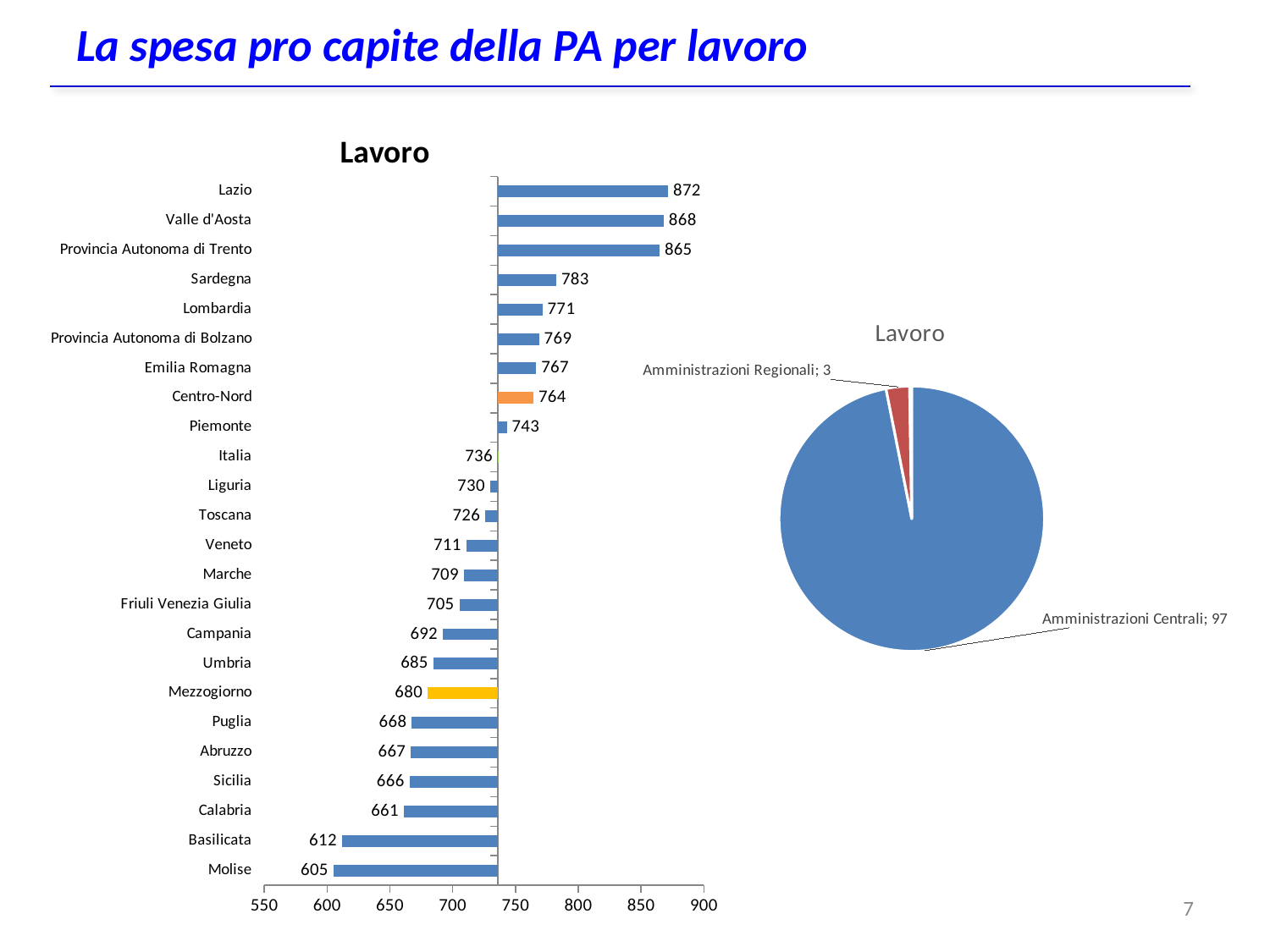
In the bar chart on the left, which category has the lowest value? Molise In the bar chart on the left, what is the difference between the values for Centro-Nord and Mezzogiorno? 84 How many categories are shown in the bar chart on the left? 24 In the bar chart on the left, what is the value for Lazio? 872 What kind of chart is the chart on the left of the slide? Bar chart In the pie chart on the right, what is the value for Amministrazioni Centrali? 97 In the bar chart on the left, which category has the highest value? Lazio In the pie chart on the right, what is the value for Amministrazioni Regionali? 3 In the bar chart on the left, what is the value for Italia? 736 In the bar chart on the left, which has a larger value, Sardegna or Lombardia? Sardegna In the bar chart on the left, what is the value for Mezzogiorno? 680 What is the title of the pie chart on the right? Lavoro